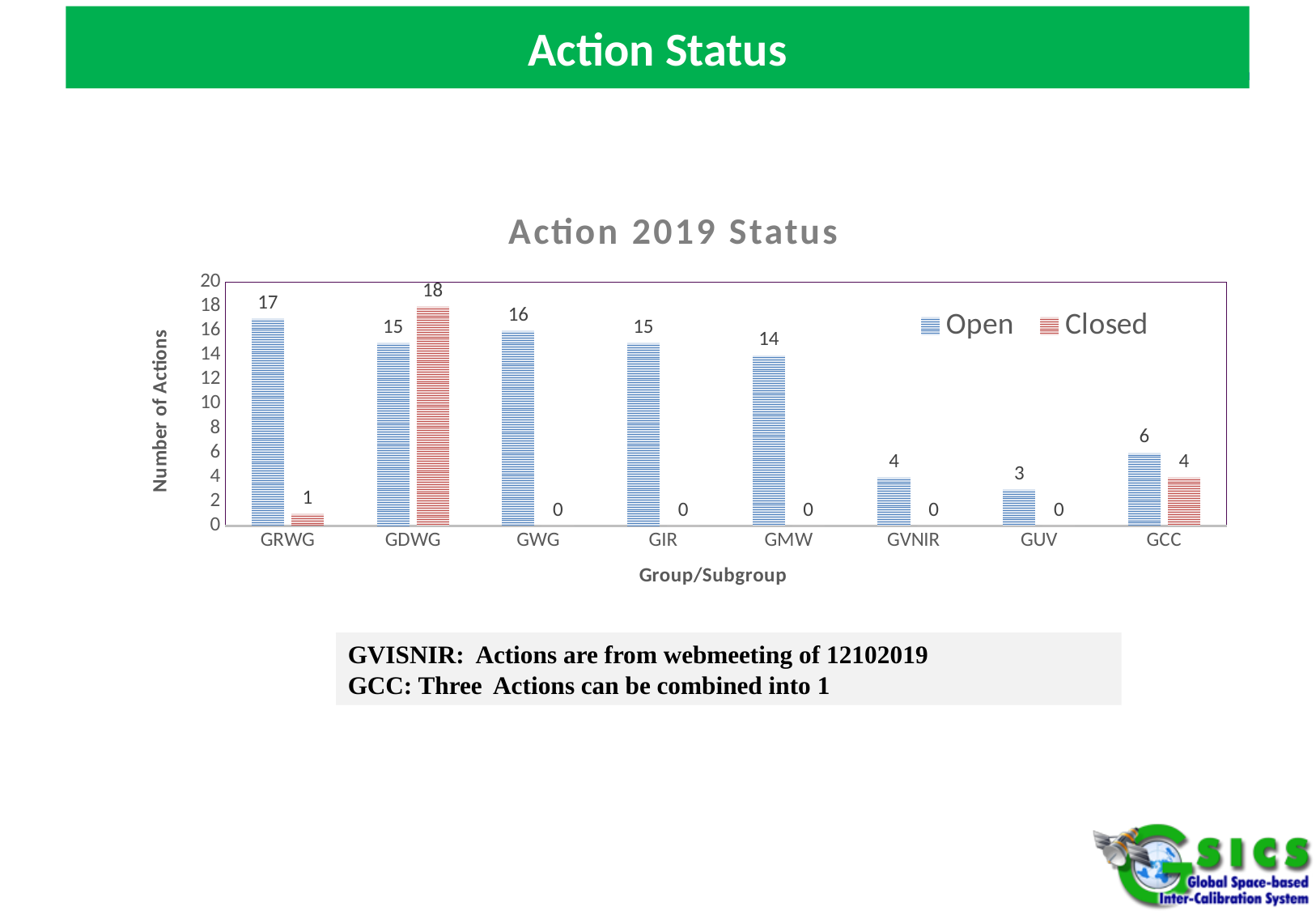
Which is larger for GDWG, the Open or the Closed value? Closed Which group has the highest number of Closed actions? GDWG How many series does the legend list? 2 Which group has the lowest number of Open actions? GUV What is the number of Open actions for GRWG? 17 What is the number of Closed actions for GCC? 4 What is the title of the chart? Action 2019 Status How many groups/subgroups are shown on the x axis? 8 What is the number of Closed actions for GDWG? 18 What kind of chart is shown? Bar chart What is the number of Open actions for GMW? 14 What is the difference between Open and Closed actions for GRWG? 16